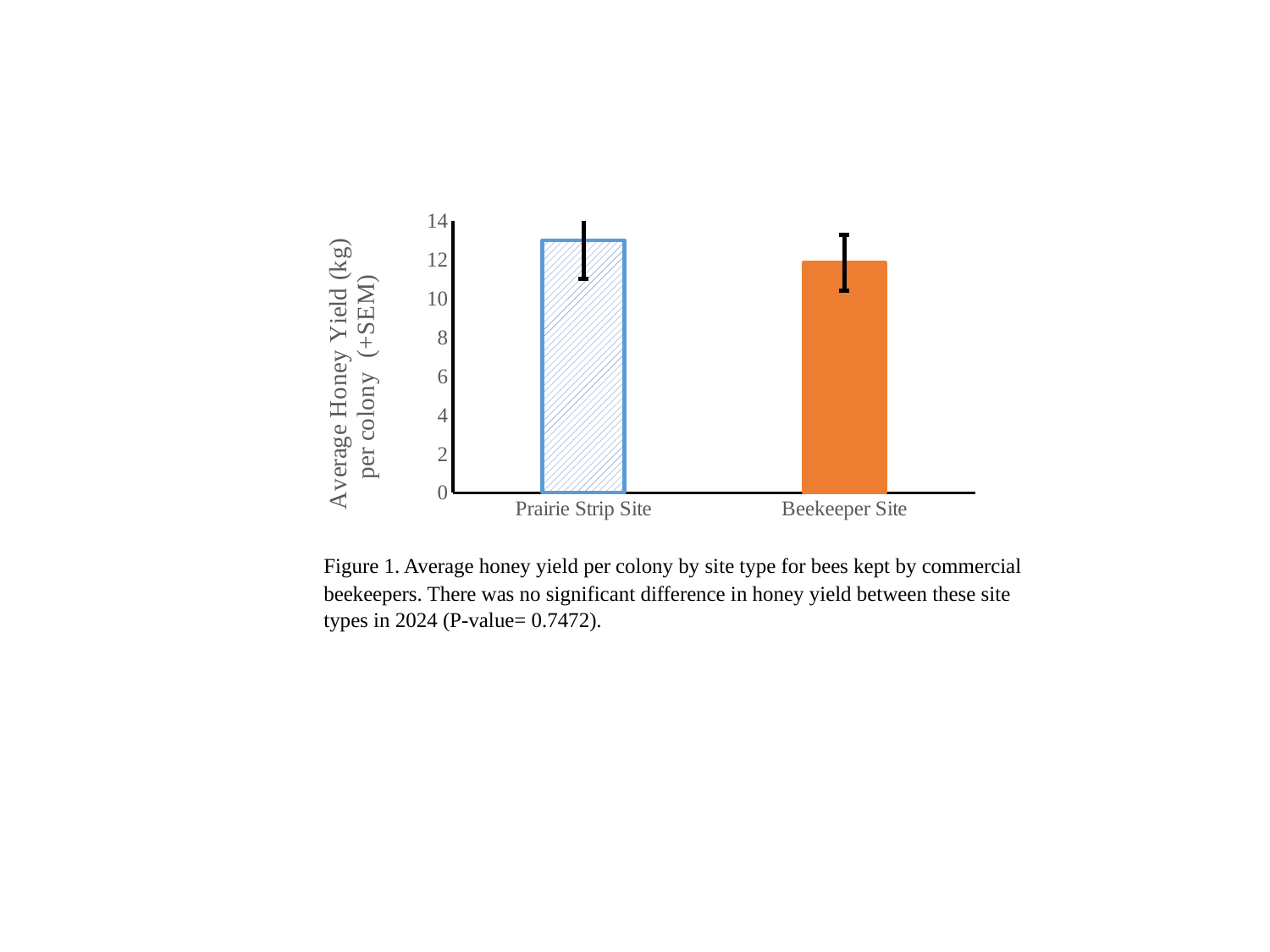
Is the value for Prairie Strip Site greater or less than 14? less What colour is the bar for Beekeeper Site? Orange Which is larger, the bar for Prairie Strip Site or the bar for Beekeeper Site? Prairie Strip Site Is the value for Beekeeper Site greater or less than 10? greater Which site type has the lower average honey yield per colony? Beekeeper Site What kind of chart is shown on the slide? Bar chart How many site types (categories) are plotted on the chart? 2 Is the value for Prairie Strip Site greater or less than 12? greater Which site type has the higher average honey yield per colony? Prairie Strip Site What is the label on the vertical axis of the chart? Average Honey Yield (kg) per colony (+SEM)